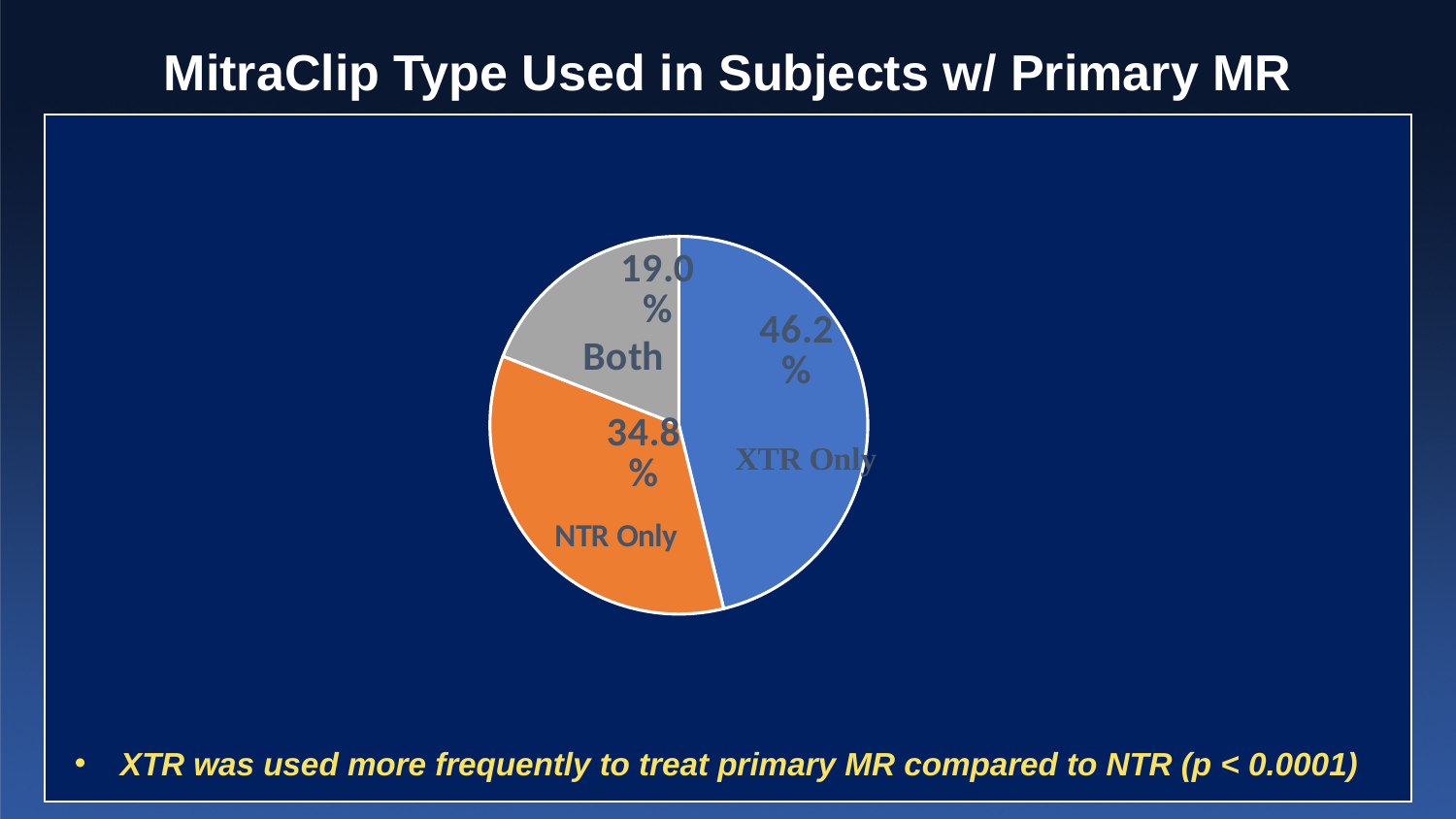
Which clip type category has the largest share of the pie? XTR Only Which is larger, the share for NTR Only or the share for Both? NTR Only Which clip type category has the smallest share of the pie? Both What is the difference in percentage points between NTR Only and Both? 15.8 What is the difference in percentage points between XTR Only and NTR Only? 11.4 What percentage of subjects with primary MR were treated with XTR Only? 46.2% What kind of chart is shown on the slide? pie chart How many slices does the pie chart have? 3 What colour is the NTR Only slice of the pie chart? orange What percentage of subjects with primary MR were treated with NTR Only? 34.8% What percentage of subjects with primary MR were treated with Both clip types? 19.0% What is the title of the slide containing the pie chart? MitraClip Type Used in Subjects w/ Primary MR